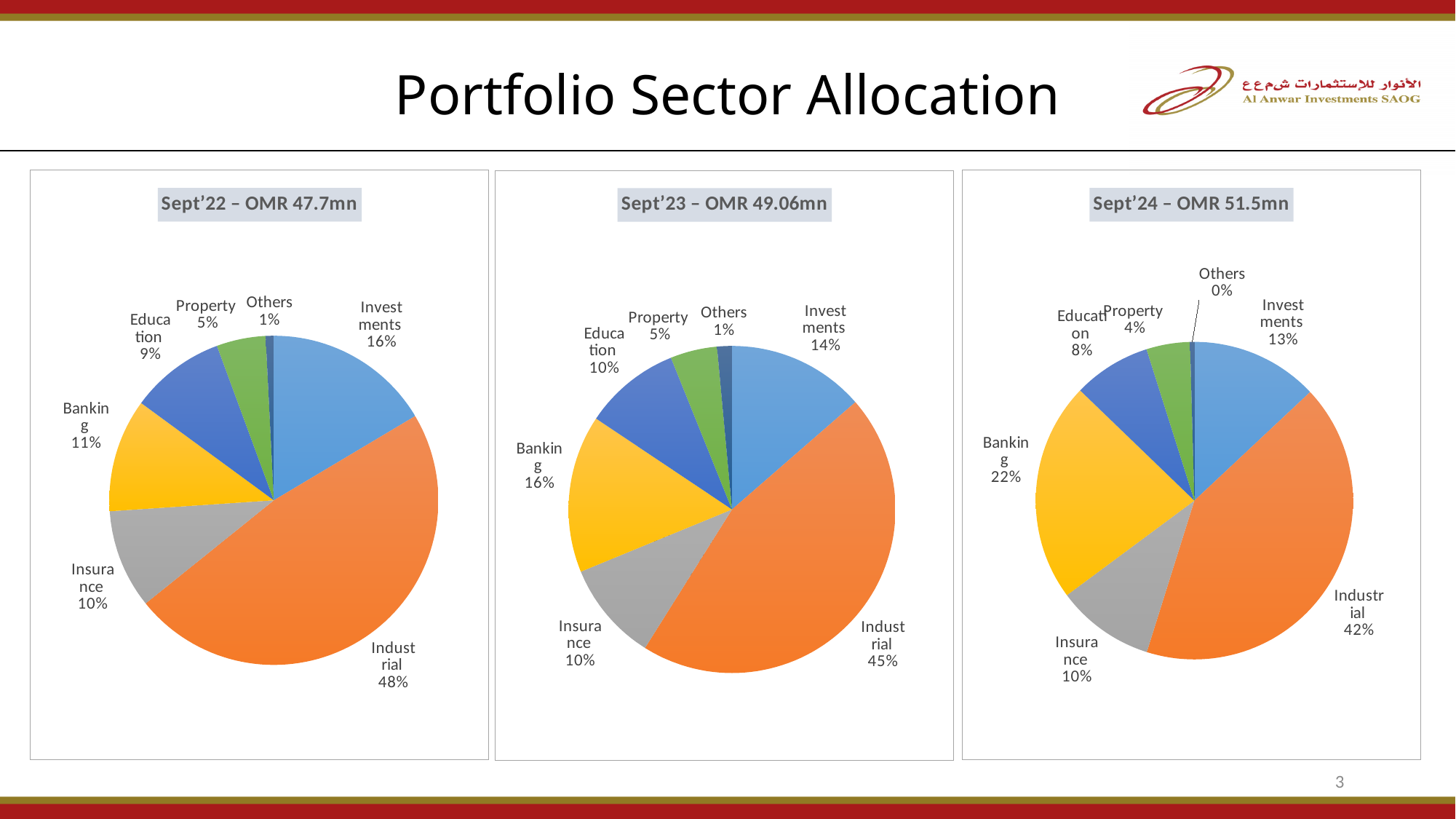
In the Sept'24 – OMR 51.5mn chart, what share does Others hold? 0% In the Sept'24 – OMR 51.5mn chart, which sector has the largest share? Industrial In the Sept'22 – OMR 47.7mn chart, which sector has the smallest share? Others In the Sept'22 – OMR 47.7mn chart, what share does Industrial hold? 48% In the Sept'22 – OMR 47.7mn chart, what share does Education hold? 9% In the Sept'23 – OMR 49.06mn chart, what is the difference between the Industrial and Banking shares? 29% How many pie charts are shown on the slide? 3 In the Sept'24 – OMR 51.5mn chart, which is larger, Banking or Insurance? Banking What kind of chart is the Sept'22 – OMR 47.7mn chart? Pie chart How many sectors are shown in the Sept'23 – OMR 49.06mn chart? 7